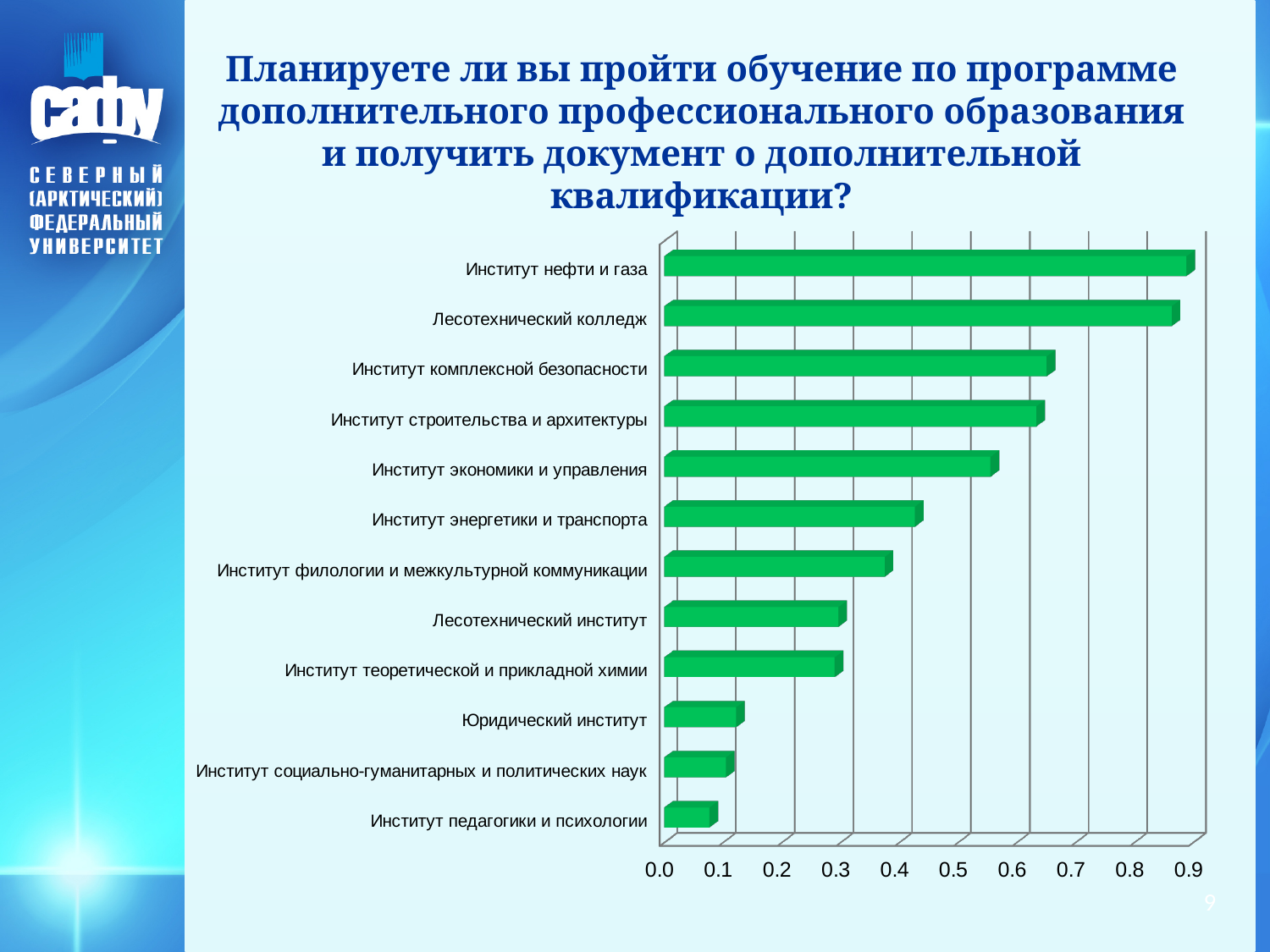
Is the value for Институт комплексной безопасности greater or less than 0.6? greater Is the value for Юридический институт greater or less than 0.1? greater Is the value for Лесотехнический колледж greater or less than 0.8? greater Which has a larger value: Институт экономики и управления or Институт энергетики и транспорта? Институт экономики и управления Which has a larger value: Институт филологии и межкультурной коммуникации or Лесотехнический институт? Институт филологии и межкультурной коммуникации What is the highest tick value shown on the horizontal axis? 0.9 Which institute has the lowest value in the chart? Институт педагогики и психологии How many institutes (categories) are shown in the chart? 12 What kind of chart is shown on the slide? bar chart Which institute has the highest value in the chart? Институт нефти и газа